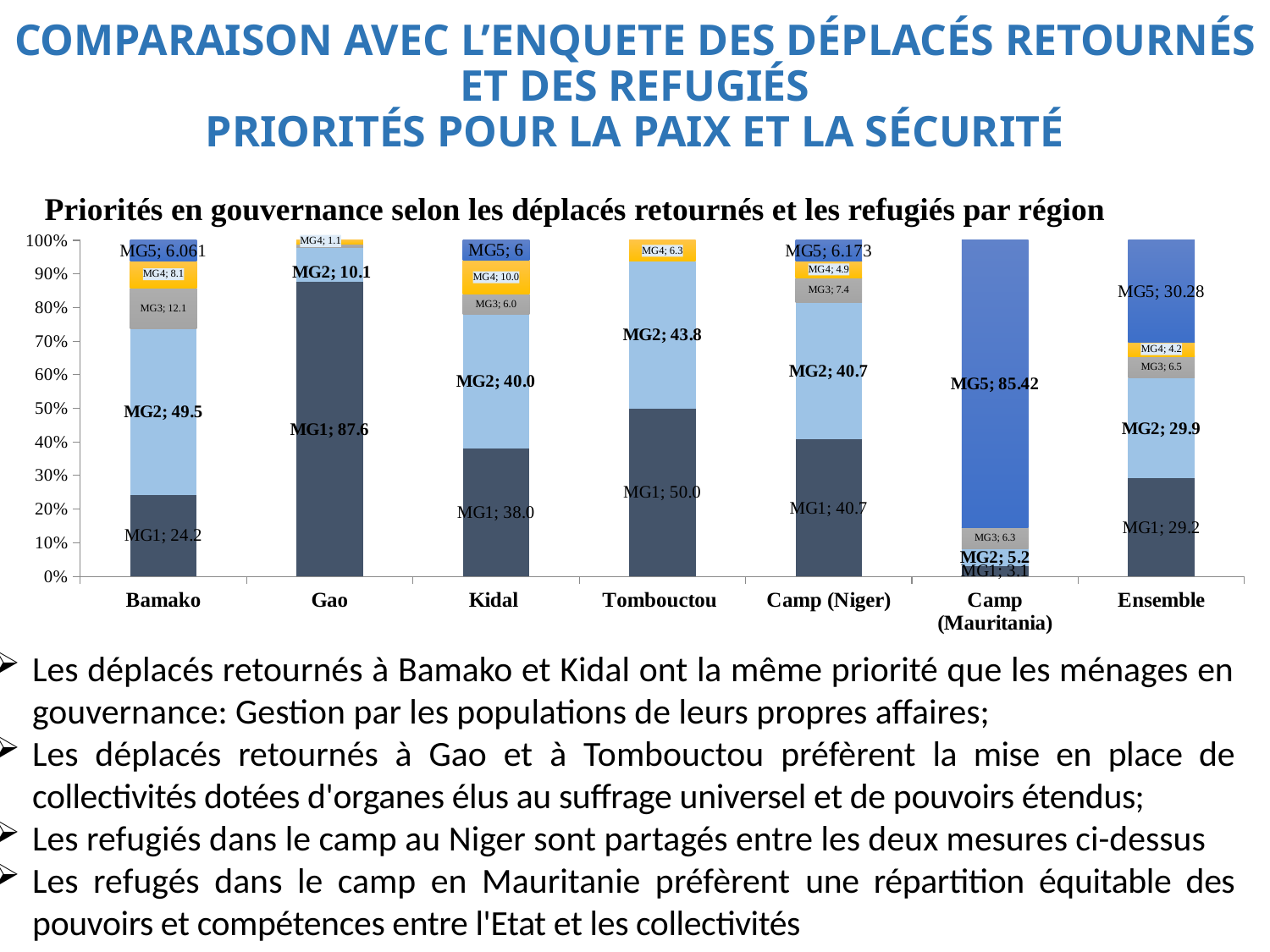
What is the MG1 value for Gao? 87.6 What kind of chart is shown on the slide? Stacked bar chart What is the difference between the MG2 and MG1 values for Bamako? 25.3 What is the MG2 value for Tombouctou? 43.8 Which region has the lowest MG1 value? Camp (Mauritania) What is the MG5 value for Ensemble? 30.28 Which is larger for Kidal, the MG1 value or the MG2 value? MG2 Which region has the highest MG1 value? Gao What is the title of the chart? Priorités en gouvernance selon les déplacés retournés et les refugiés par région What is the MG5 value for Camp (Mauritania)? 85.42 How many regions are shown on the x axis? 7 What is the MG4 value for Gao? 1.1